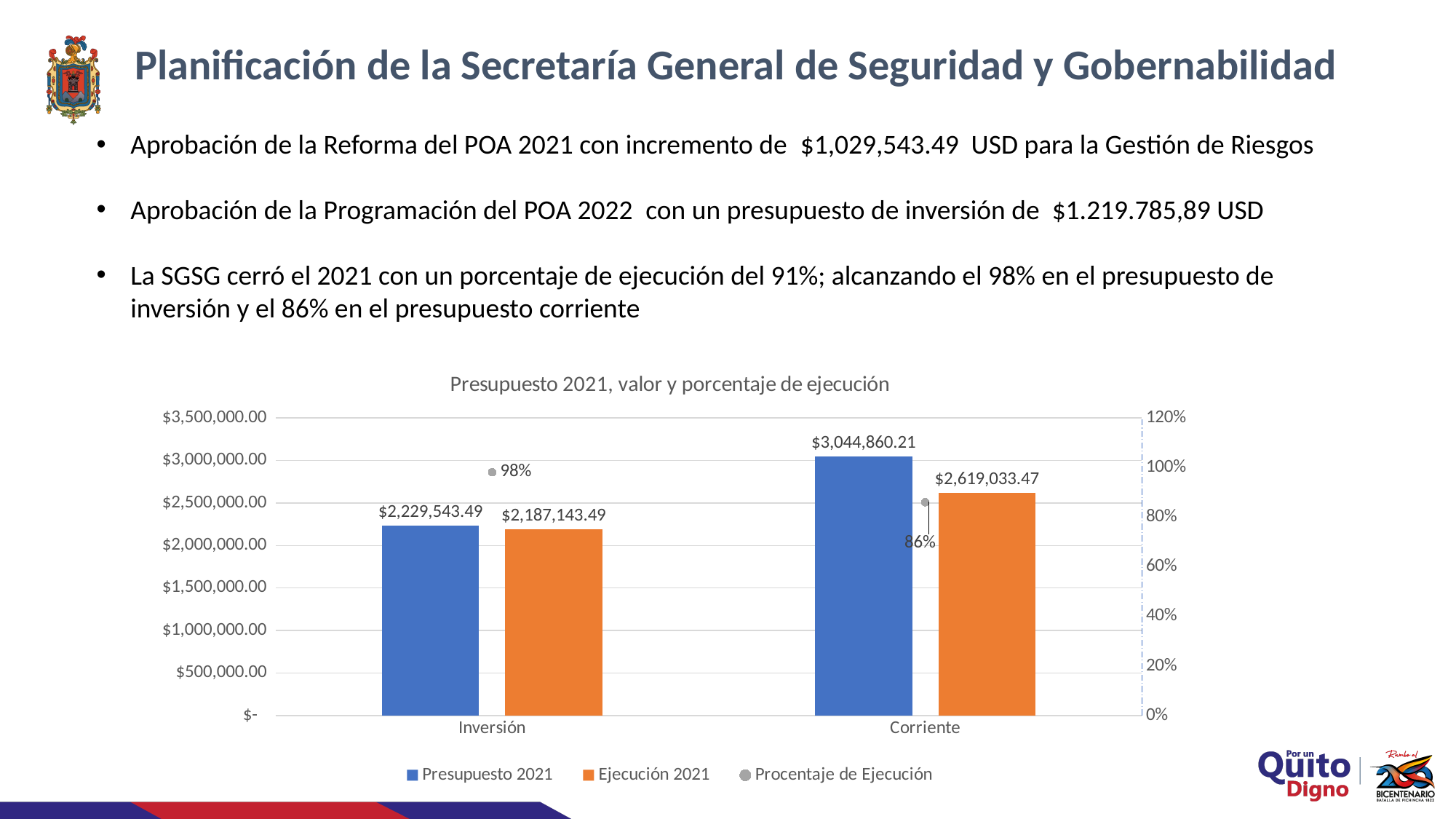
How many series does the legend list? 3 What is the title of the chart? Presupuesto 2021, valor y porcentaje de ejecución What is the difference between Presupuesto 2021 and Ejecución 2021 for Corriente? $425,826.74 Which category has the higher Presupuesto 2021 value? Corriente What is the difference between Presupuesto 2021 and Ejecución 2021 for Inversión? $42,400.00 What is the Presupuesto 2021 value for Inversión? $2,229,543.49 Is the Ejecución 2021 value for Inversión larger or smaller than the Ejecución 2021 value for Corriente? smaller What is the Porcentaje de Ejecución for Inversión? 98% How many categories are shown on the x axis? 2 What is the Ejecución 2021 value for Corriente? $2,619,033.47 What is the Porcentaje de Ejecución for Corriente? 86% Which category has the lower Porcentaje de Ejecución? Corriente